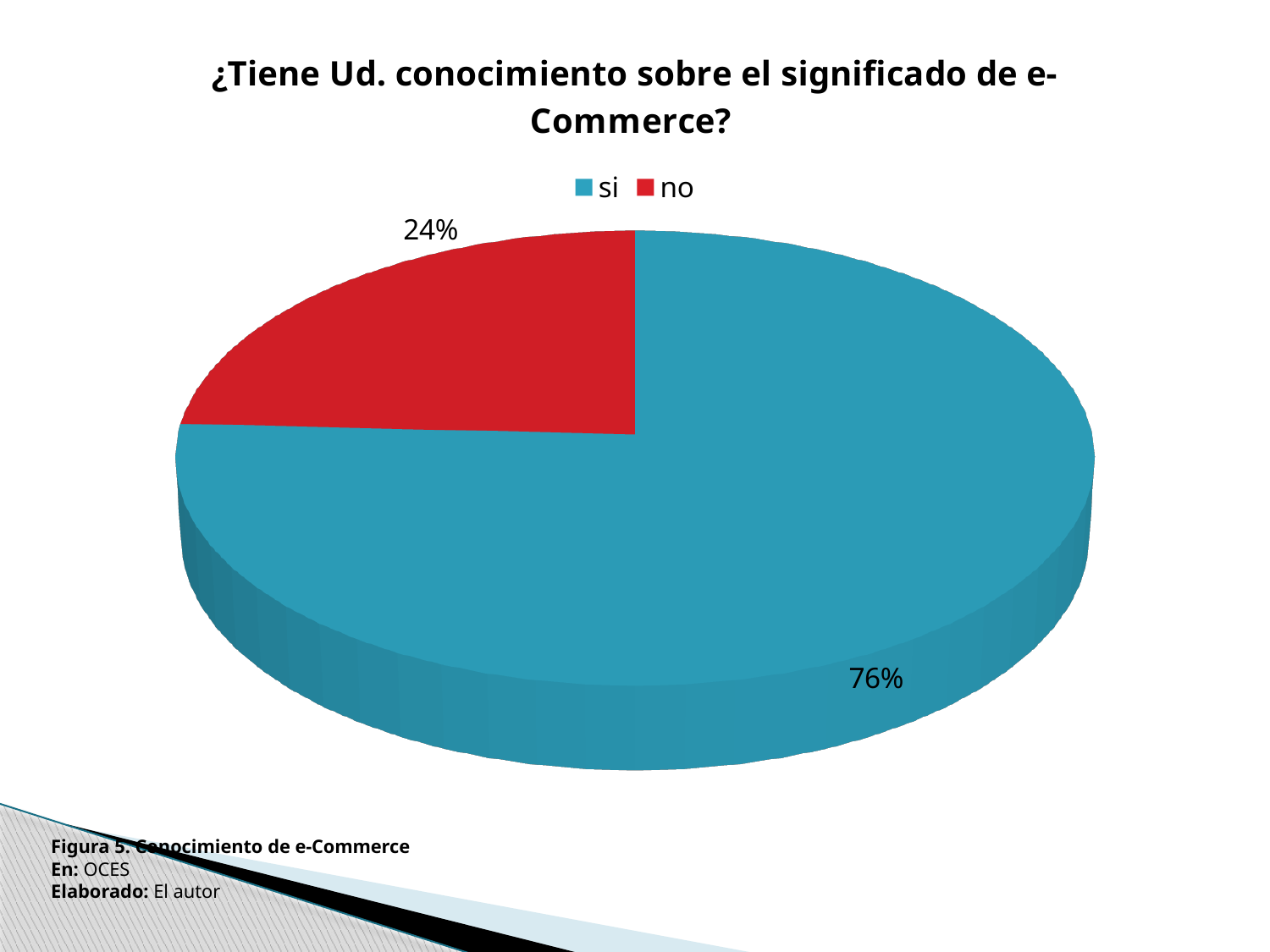
How many entries does the legend list? 2 What is the title of the chart? ¿Tiene Ud. conocimiento sobre el significado de e-Commerce? What colour is the "no" slice in the pie chart? red Which is larger, the share for "si" or the share for "no"? si Which category has the largest share of the pie? si What share of the pie does the "no" slice represent? 24% What kind of chart is shown on the slide? pie chart What percentage of respondents answered "si"? 76% Which category has the smallest share of the pie? no What percentage of respondents answered "no"? 24% What is the difference in percentage points between the "si" and "no" slices? 52 How many slices does the pie chart have? 2